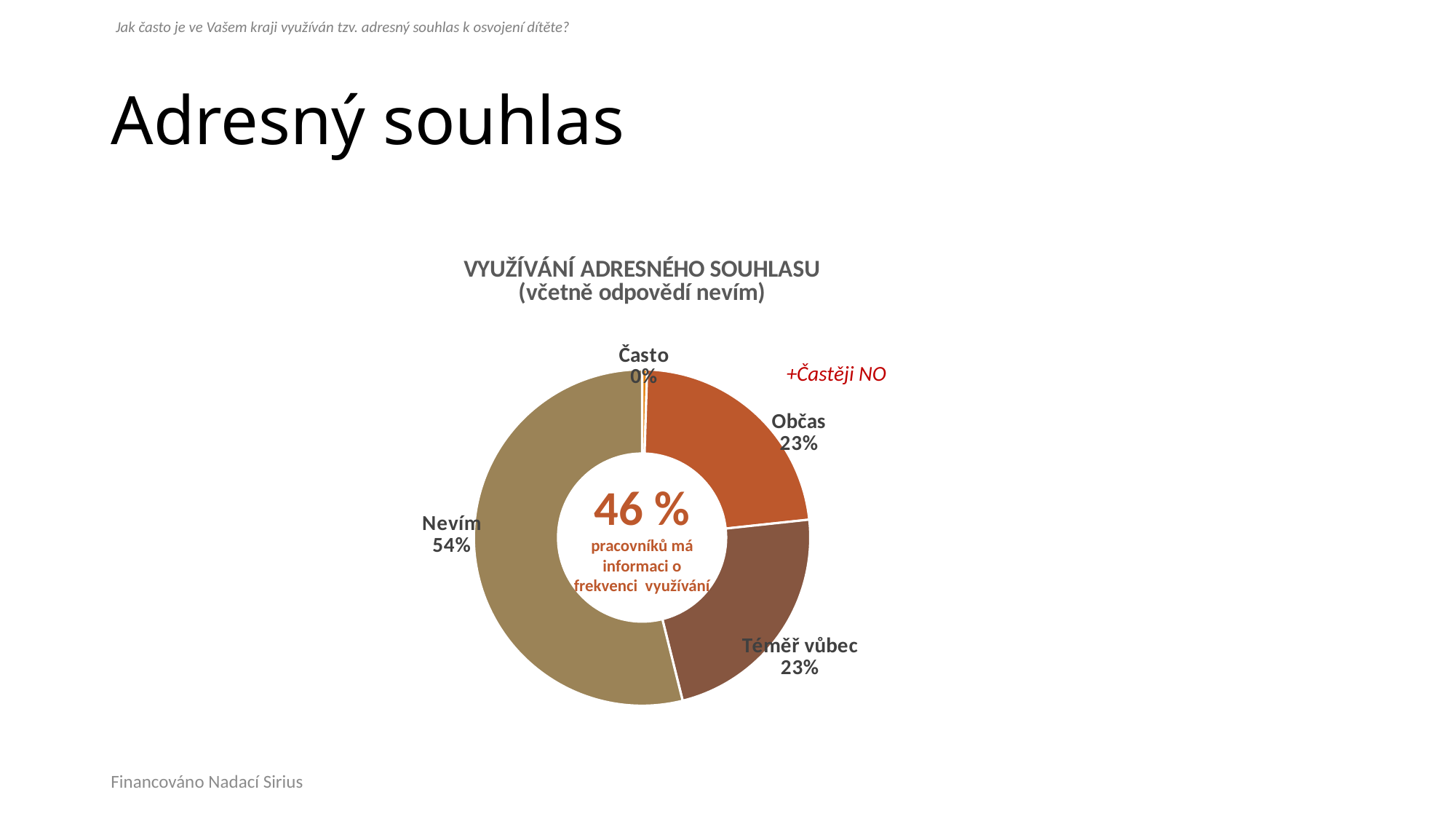
What percentage is printed in the centre of the doughnut chart? 46 % What is the value for Občas? 23% What is the difference between the values for Nevím and Občas? 31 percentage points What is the title of the chart? VYUŽÍVÁNÍ ADRESNÉHO SOUHLASU (včetně odpovědí nevím) Which is larger, the value for Nevím or the value for Téměř vůbec? Nevím What type of chart is shown on the slide? Doughnut (pie) chart Which category has the largest share of the chart? Nevím How many categories are shown in the chart? 4 What is the value for Téměř vůbec? 23% What is the value for Často? 0% What is the value for Nevím? 54% Which category has the smallest share of the chart? Často